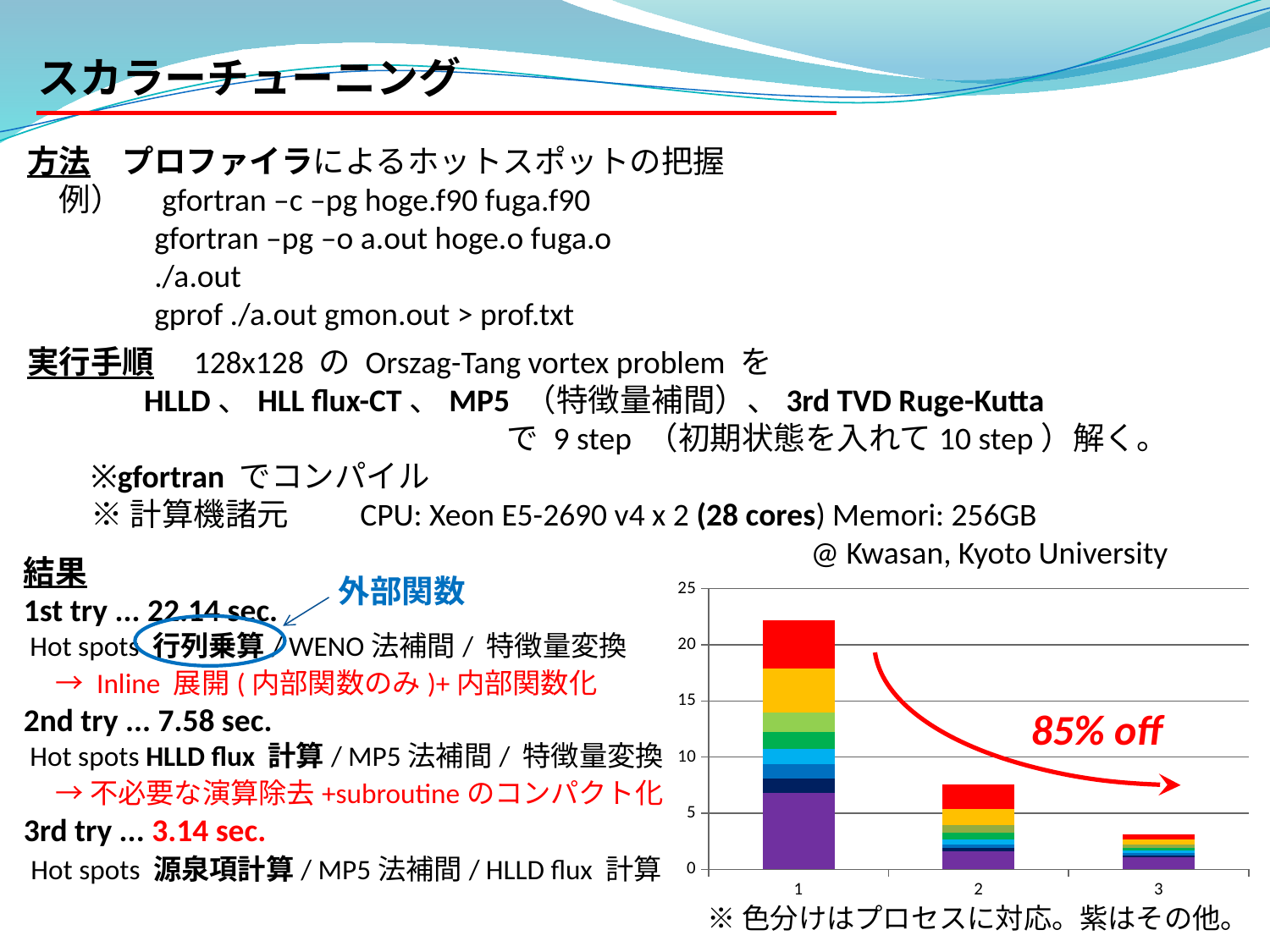
What percentage reduction is annotated next to the red arrow on the chart? 85% off Is the total value of the bar for category 2 greater or less than 5? greater Which category has the shortest bar on the chart? 3 Is the total value of the bar for category 1 greater or less than 20? greater Which category has the tallest bar on the chart? 1 What kind of chart is shown on the slide? stacked bar chart Is the total value of the bar for category 3 greater or less than 5? less Do the bar totals rise or fall from category 1 to category 3? fall Which bar is taller, category 2 or category 3? 2 What is the highest tick value shown on the vertical axis of the chart? 25 How many bars (categories) are plotted on the chart? 3